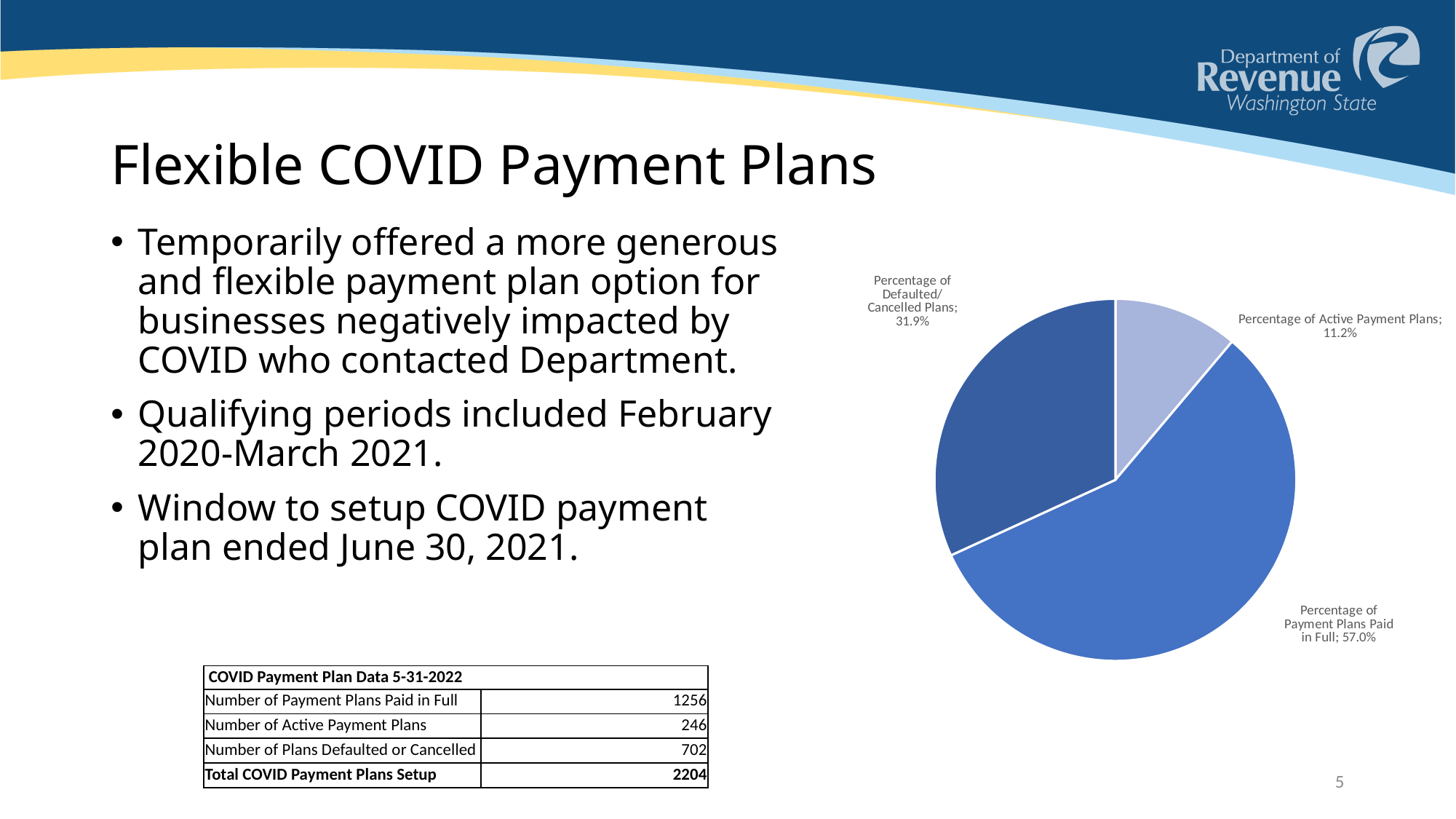
Which slice of the pie chart is the largest? Percentage of Payment Plans Paid in Full What percentage does the pie chart show for Defaulted/Cancelled Plans? 31.9% Which slice of the pie chart is the smallest? Percentage of Active Payment Plans What is the difference in percentage points between the Paid in Full slice and the Defaulted/Cancelled Plans slice in the pie chart? 25.1 How many slices does the pie chart have? 3 In the pie chart, which is larger: the Defaulted/Cancelled Plans slice or the Active Payment Plans slice? Defaulted/Cancelled Plans What is the difference in percentage points between the Defaulted/Cancelled Plans slice and the Active Payment Plans slice in the pie chart? 20.7 What percentage does the pie chart show for Active Payment Plans? 11.2% What kind of chart is shown on the slide? Pie chart What share of the pie does the Active Payment Plans slice represent? 11.2% Which slice of the pie chart is shown in the lightest shade of blue? Percentage of Active Payment Plans What percentage does the pie chart show for Payment Plans Paid in Full? 57.0%